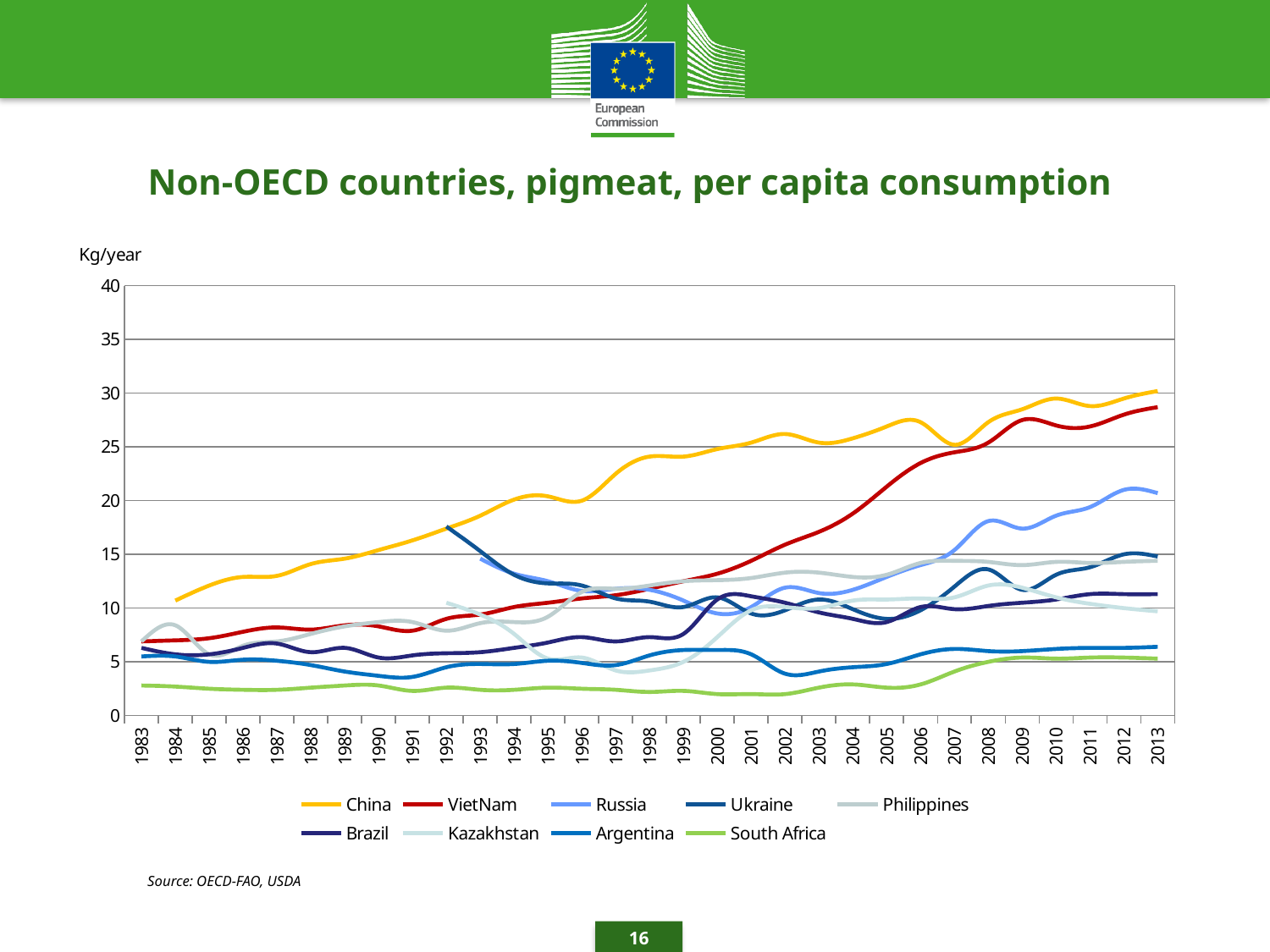
Is the value for China in 2013 greater or less than 25? greater Is the value for South Africa in 2000 greater or less than 5? less Is the value for Russia in 2013 greater or less than 15? greater Which country has the highest per capita pigmeat consumption in 2013? China What unit is shown above the y axis? Kg/year What kind of chart is shown on the slide? line chart Does the value for VietNam rise or fall from 1983 to 2013? rise Which country has the lowest per capita pigmeat consumption in 2000? South Africa How many years are shown along the x axis? 31 Which is higher in 2013, Russia or Ukraine? Russia How many series does the legend list? 9